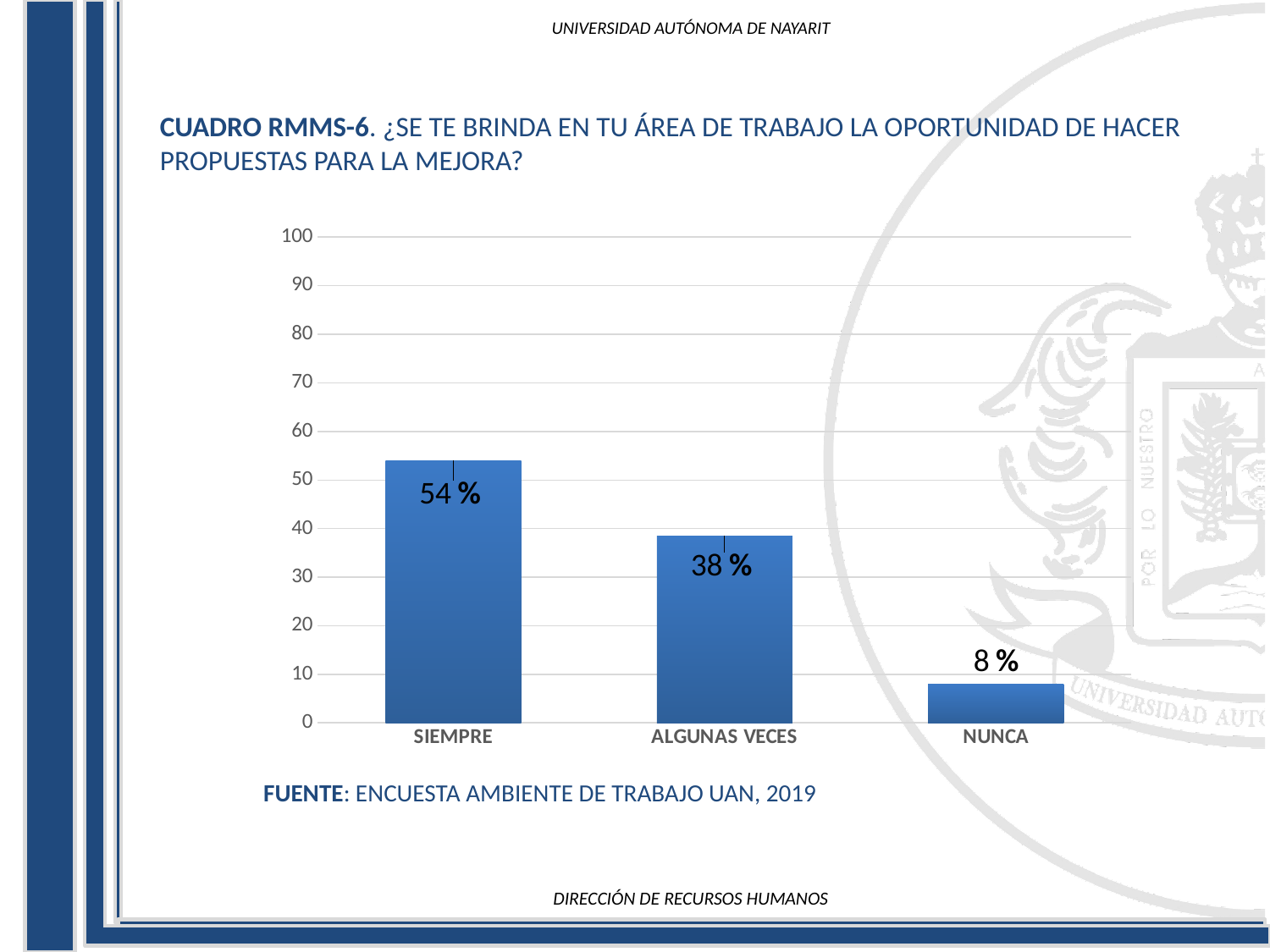
What kind of chart is shown on the slide? bar chart What is the difference between the values for SIEMPRE and ALGUNAS VECES? 16 % Is the value for SIEMPRE greater or less than 50? greater What is the difference between the values for ALGUNAS VECES and NUNCA? 30 % Which is larger, the value for ALGUNAS VECES or the value for NUNCA? ALGUNAS VECES How many categories are shown on the x axis? 3 Which category has the lowest value? NUNCA Which category has the highest value? SIEMPRE What is the value for NUNCA? 8 % What is the value for SIEMPRE? 54 % What is the value for ALGUNAS VECES? 38 % What is the source cited below the chart? ENCUESTA AMBIENTE DE TRABAJO UAN, 2019